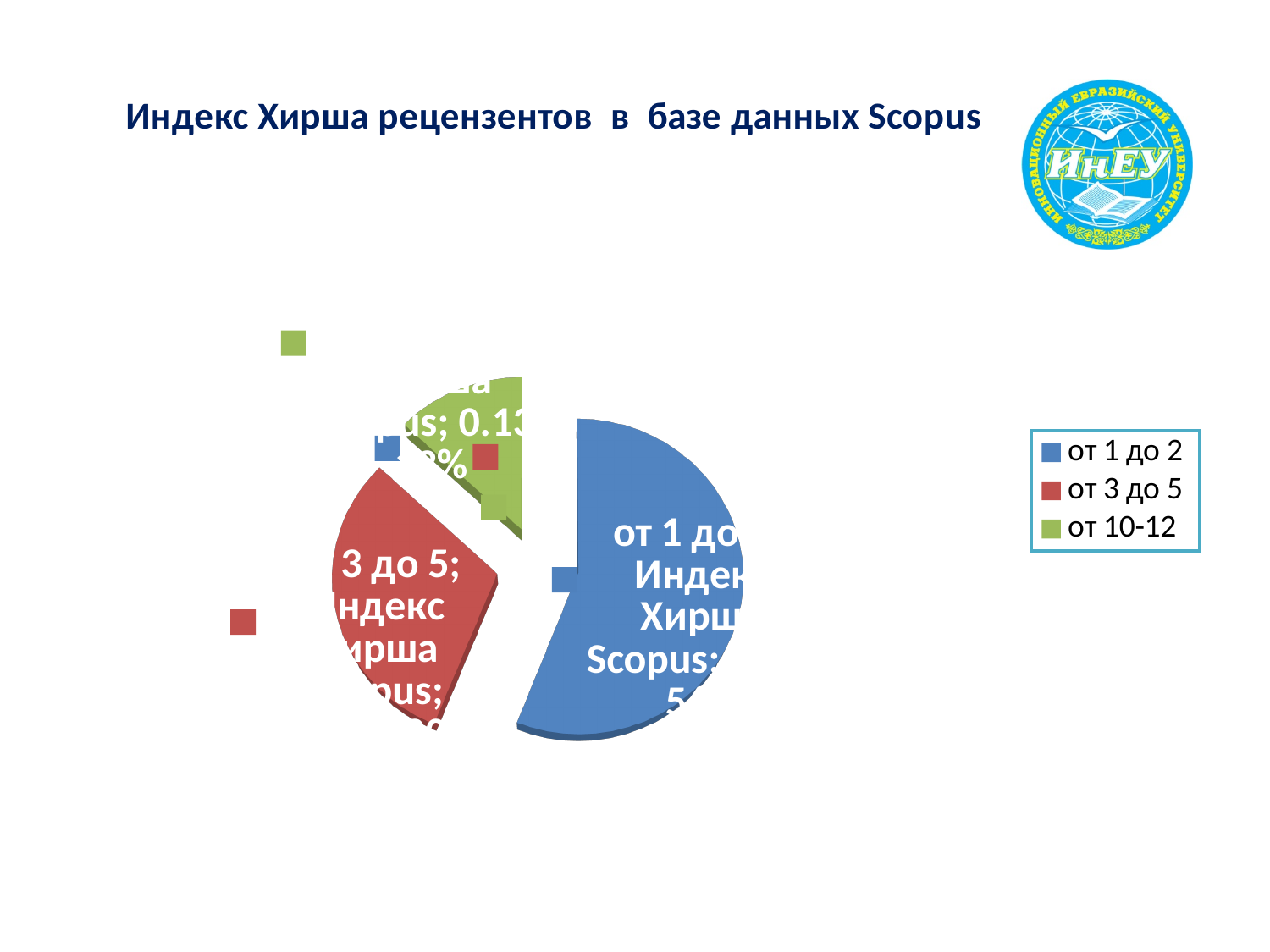
What colour is the "от 3 до 5" slice in the pie chart? red What kind of chart is shown on the slide? pie chart Which category has the smallest slice in the pie chart? от 10-12 Which category has the largest slice in the pie chart? от 1 до 2 Which slice is larger, "от 3 до 5" or "от 10-12"? от 3 до 5 What is the title of the slide containing the pie chart? Индекс Хирша рецензентов в базе данных Scopus How many entries does the legend of the pie chart list? 3 How many slices does the pie chart have? 3 Which slice is larger, "от 1 до 2" or "от 3 до 5"? от 1 до 2